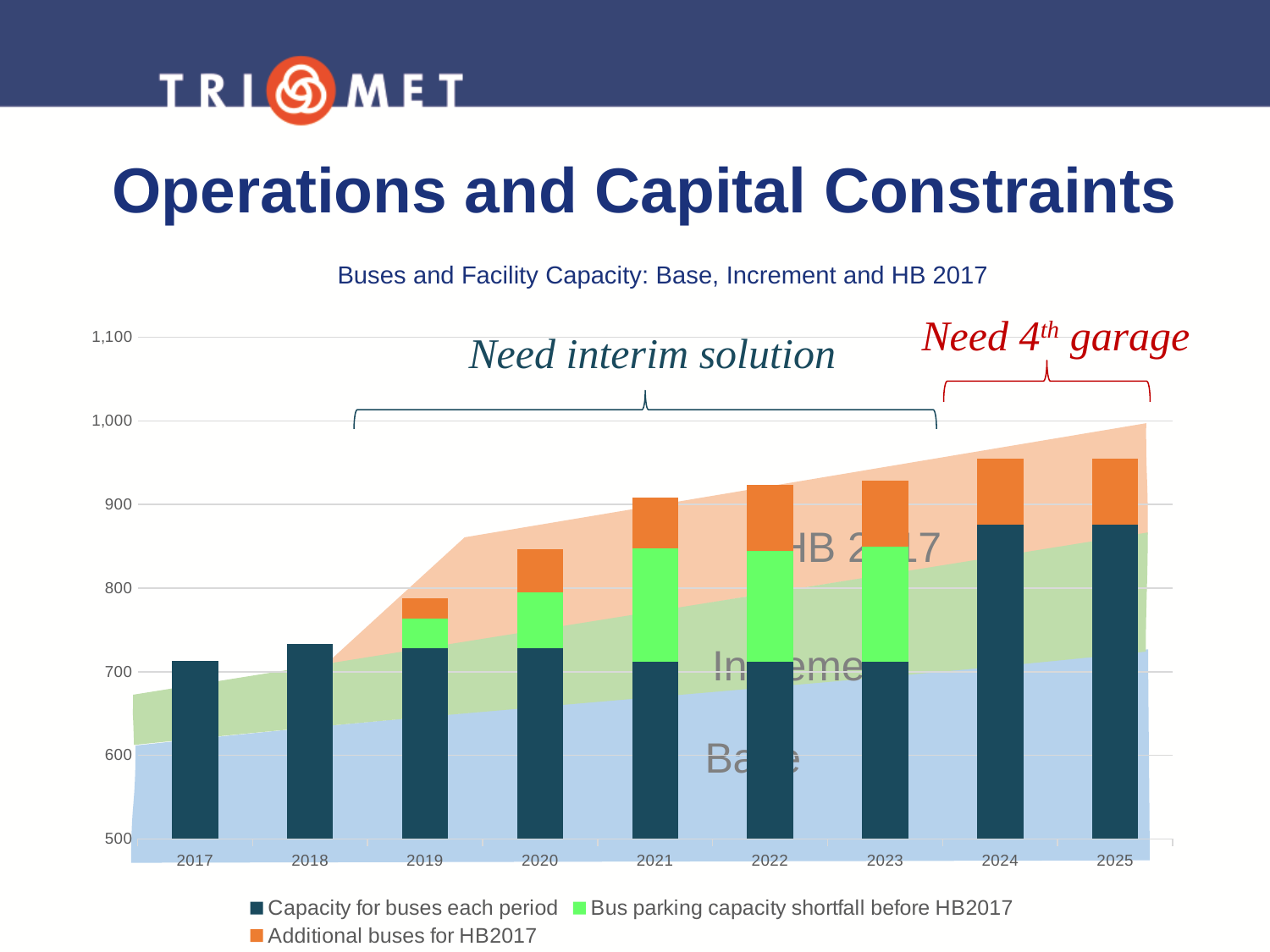
What kind of chart is shown on the slide? Bar chart Is the value for 'Capacity for buses each period' in 2017 greater or less than 700? greater Which colour represents 'Additional buses for HB2017' in the legend? Orange How many years are shown on the x axis of the chart? 9 Is the total height of the stacked bar for 2025 greater or less than 900? greater Is the value for 'Capacity for buses each period' in 2024 greater or less than 900? less How many series does the chart's legend list? 3 Which year has the lowest total stacked bar? 2017 Which year has the larger total stacked bar, 2019 or 2020? 2020 Do the total stacked bar heights generally rise or fall from 2017 to 2025? Rise What is the title of the chart? Buses and Facility Capacity: Base, Increment and HB 2017